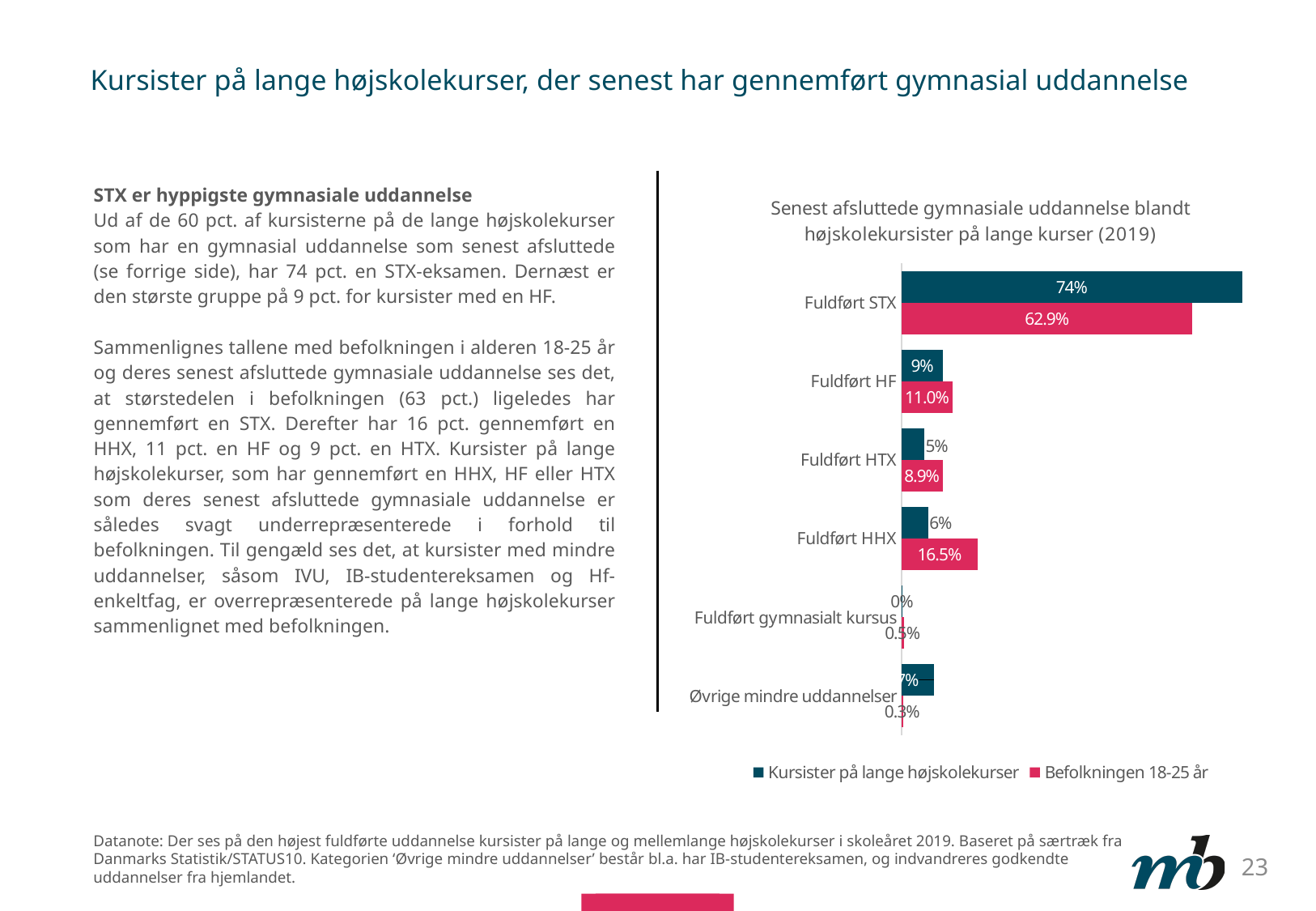
How many series does the legend list? 2 What is the value for Fuldført STX in the Befolkningen 18-25 år series? 62.9% What kind of chart is shown on the slide? Bar chart What is the difference between the two series' values for Fuldført STX? 11.1 percentage points What is the value for Fuldført HTX in the Befolkningen 18-25 år series? 8.9% How many categories are shown on the chart? 6 What is the value for Fuldført HF in the Kursister på lange højskolekurser series? 9% For Fuldført HHX, which series has the larger value? Befolkningen 18-25 år What is the title of the chart? Senest afsluttede gymnasiale uddannelse blandt højskolekursister på lange kurser (2019) What is the value for Fuldført HHX in the Befolkningen 18-25 år series? 16.5% What is the value for Fuldført STX in the Kursister på lange højskolekurser series? 74% Which category has the highest value in the Kursister på lange højskolekurser series? Fuldført STX